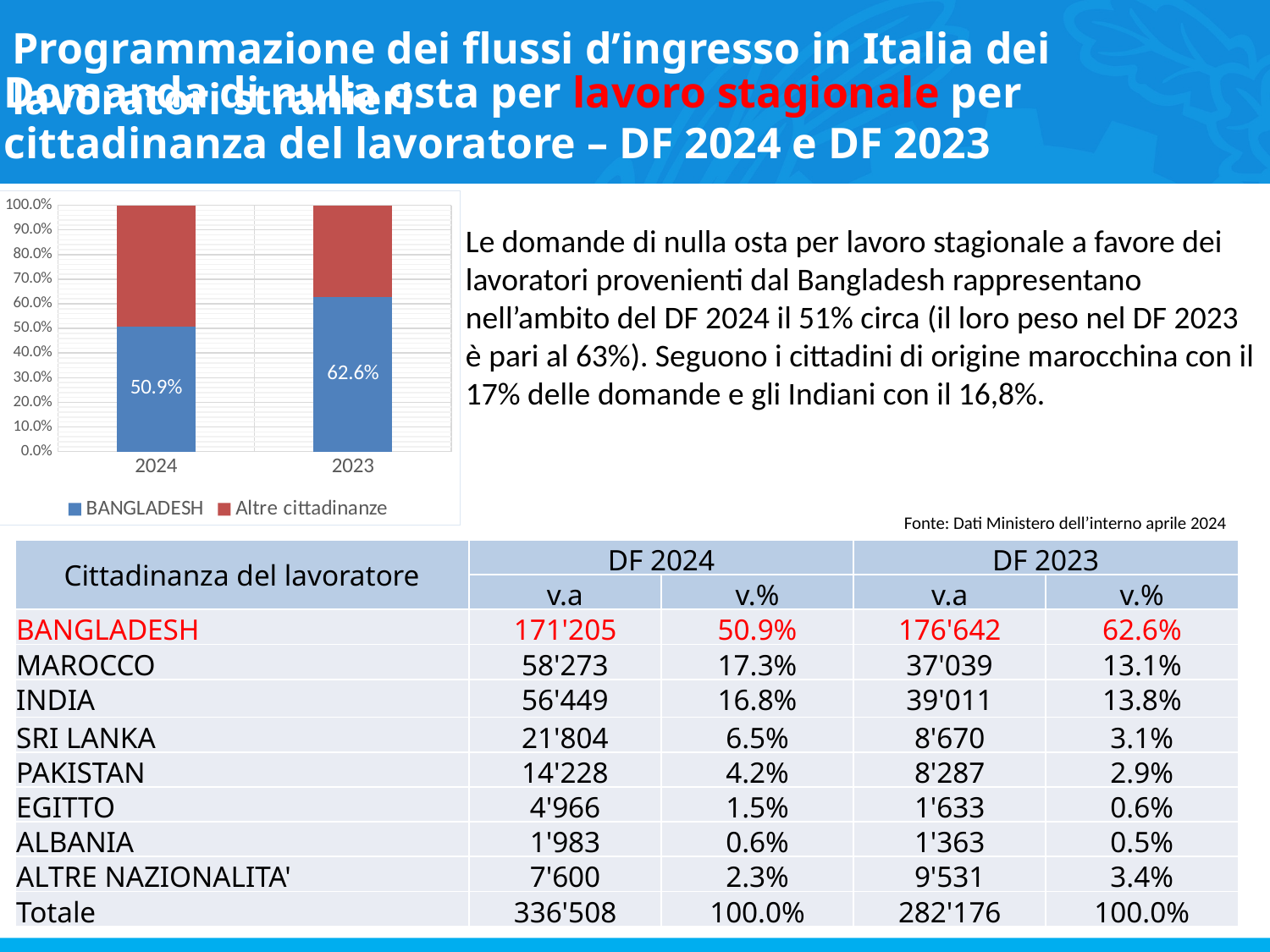
Which year has the larger BANGLADESH share, 2024 or 2023? 2023 What kind of chart is shown on the slide? Stacked bar chart What is the difference between the BANGLADESH share in 2023 and in 2024? 11.7% Does the BANGLADESH share rise or fall from the left bar (2024) to the right bar (2023)? Rises How many categories are shown on the x axis of the chart? 2 What is the value shown for BANGLADESH in the 2024 bar? 50.9% What is the value shown for BANGLADESH in the 2023 bar? 62.6% What colour represents the BANGLADESH series in the chart? Blue In which year is the BANGLADESH share highest? 2023 Is the value for Altre cittadinanze in 2024 greater or less than 40.0%? greater How many series does the chart legend list? 2 Is the value for Altre cittadinanze in 2023 greater or less than 50.0%? less